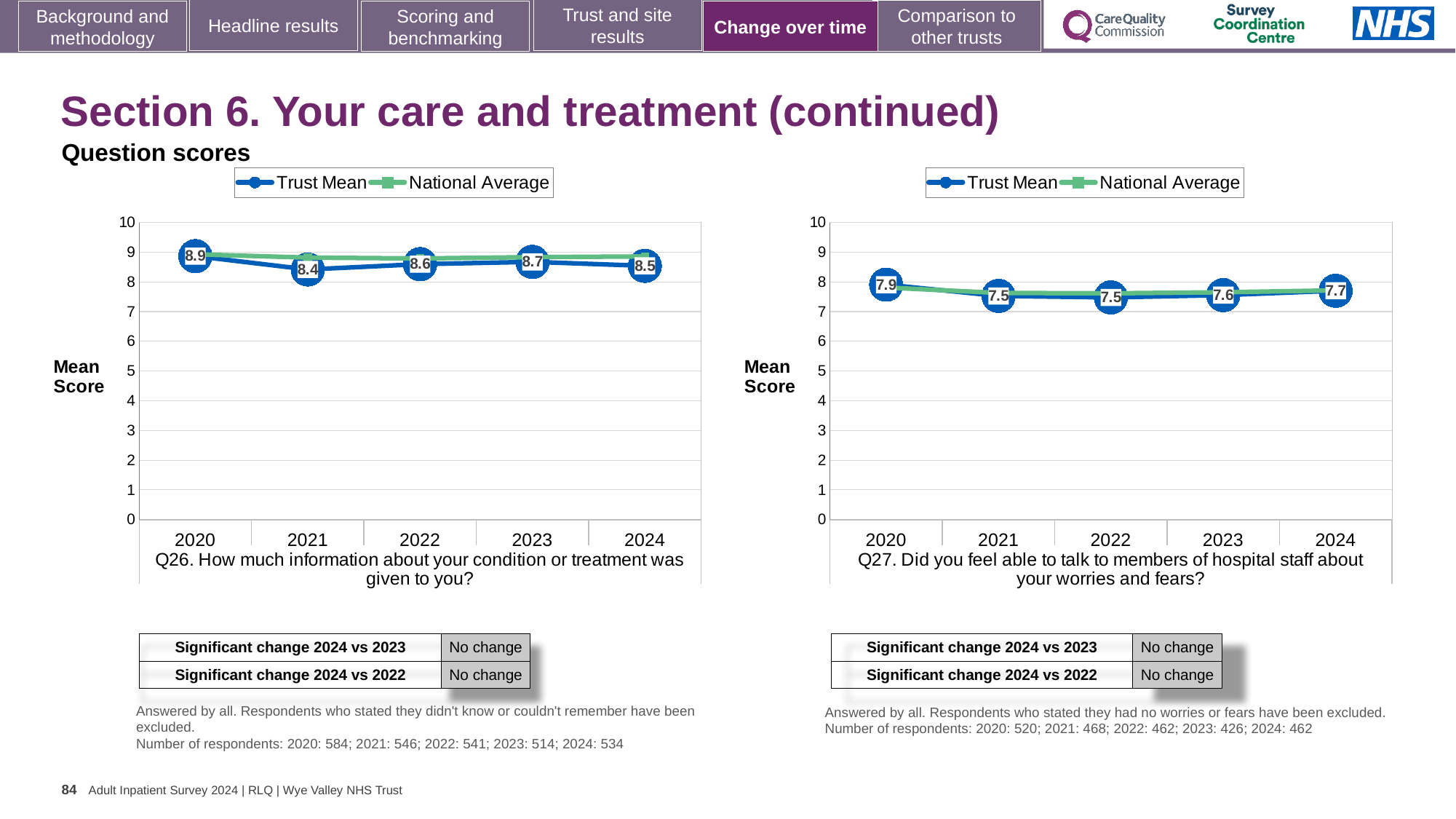
In the Q26 chart (left), what is the Trust Mean score for 2021? 8.4 In the Q26 chart (left), which year has the lowest Trust Mean score? 2021 In the Q26 chart (left), which year has the highest Trust Mean score? 2020 In the Q27 chart (right), what is the Trust Mean score for 2024? 7.7 How many years are plotted on the x axis of the Q27 chart (right)? 5 In the Q27 chart (right), which year has the highest Trust Mean score? 2020 In the Q26 chart (left), is the Trust Mean score for 2023 higher or lower than for 2024? higher In the Q27 chart (right), what is the difference between the Trust Mean scores for 2024 and 2023? 0.1 What type of chart is the Q26 chart (left)? line chart In the Q27 chart (right), what is the Trust Mean score for 2020? 7.9 In the Q26 chart (left), what is the difference between the Trust Mean scores for 2020 and 2021? 0.5 In the Q26 chart (left), what is the Trust Mean score for 2020? 8.9